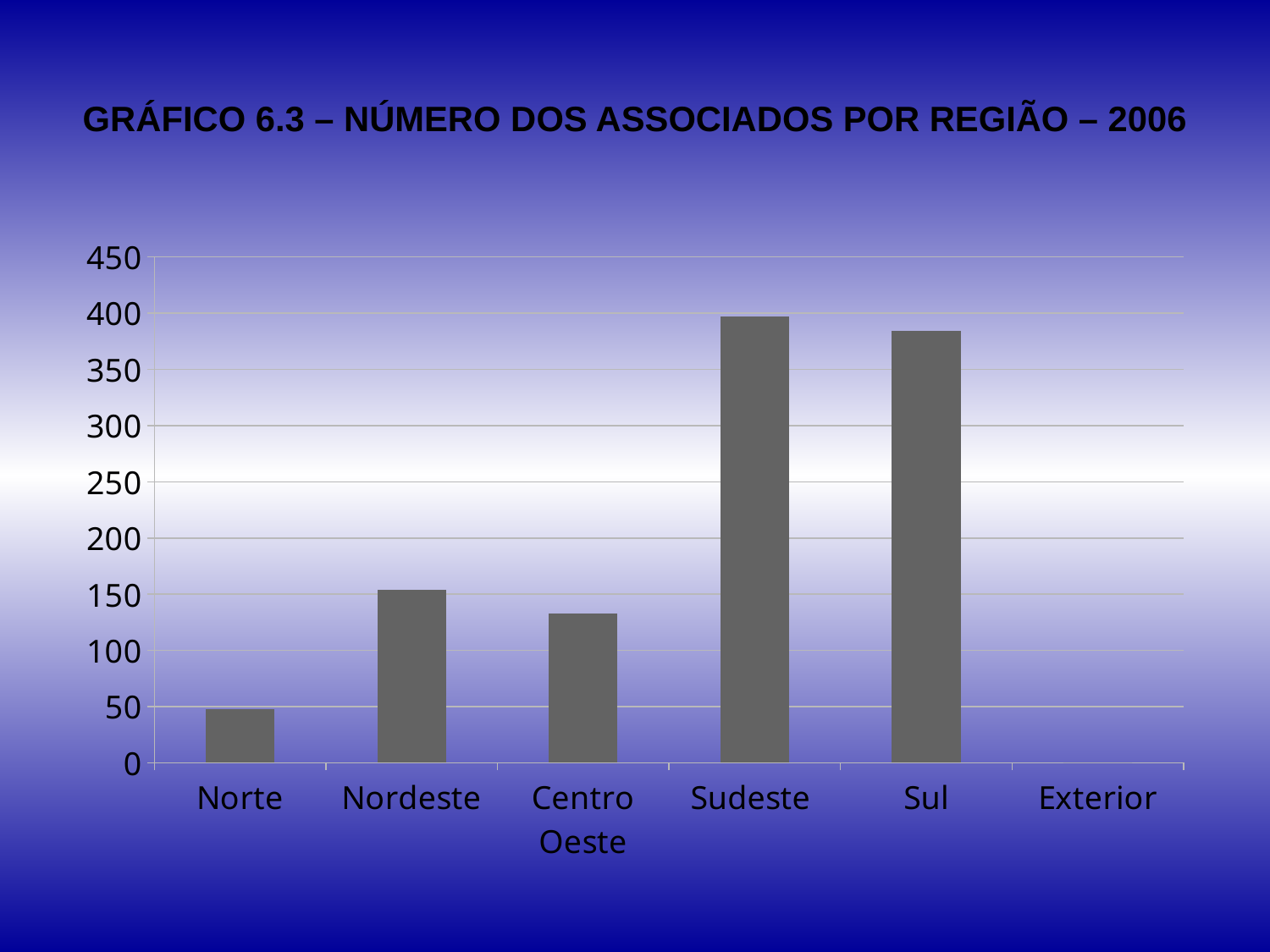
Is the value for Norte greater or less than 100? less Which region has the shortest visible bar in the chart? Norte What is the title of the chart? GRÁFICO 6.3 – NÚMERO DOS ASSOCIADOS POR REGIÃO – 2006 Is the value for Sul greater or less than 400? less Which region has the larger value, Nordeste or Centro Oeste? Nordeste Which region has the tallest bar in the chart? Sudeste Which region has the larger value, Norte or Centro Oeste? Centro Oeste Is the value for Sudeste greater or less than 350? greater What kind of chart is shown on the slide? bar chart How many regions are listed on the x axis of the chart? 6